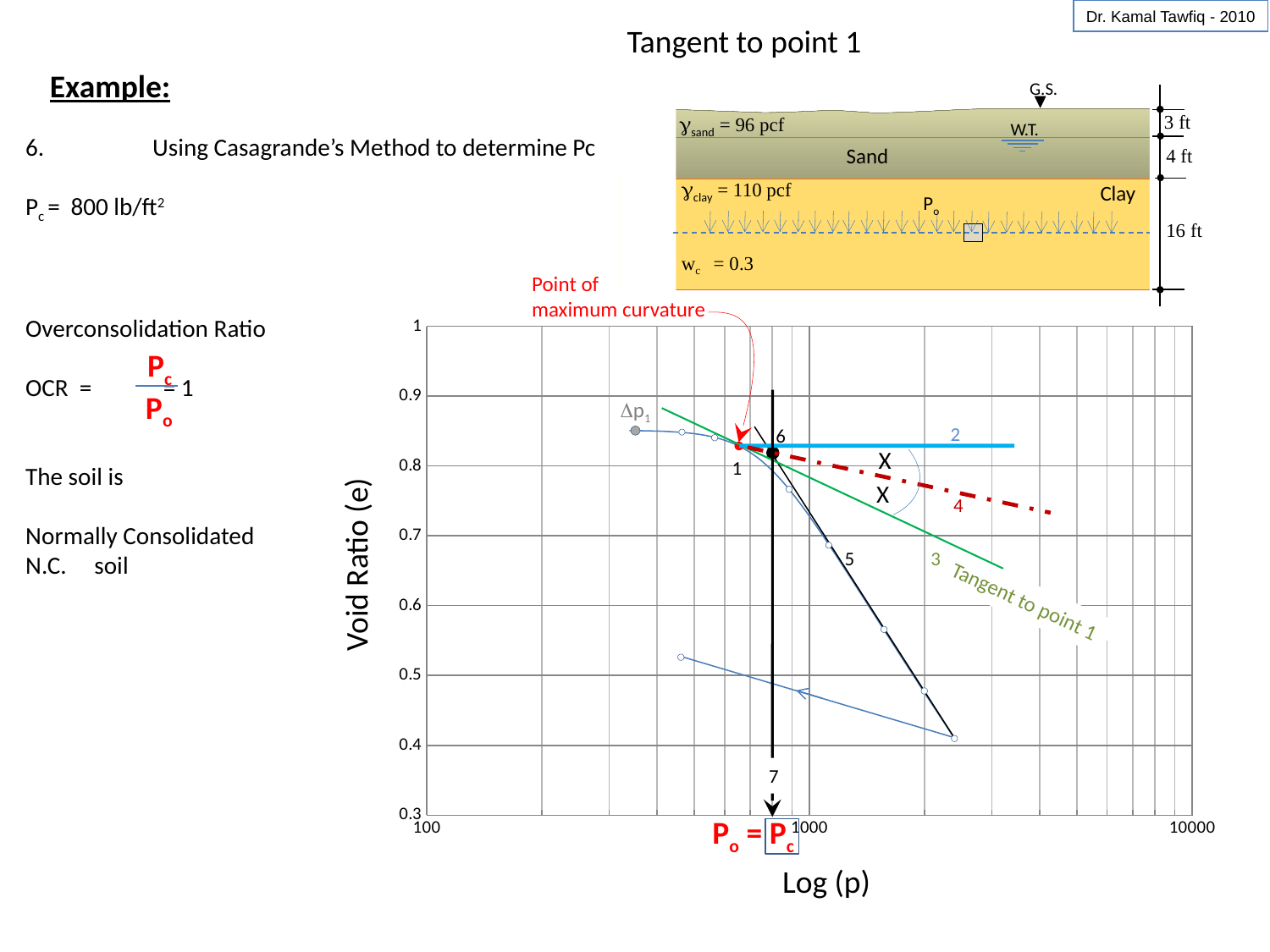
Which point has the higher void ratio, the point labelled Δp1 or the point labelled 5? Δp1 Is the pressure at the vertical line marked Po = Pc greater or less than 1000? less What is the highest tick value shown on the vertical axis of the chart? 1 What is the label of the horizontal axis of the chart? Log (p) As p increases along the x axis, does the void ratio along the main loading curve rise or fall? fall Is the void ratio at the point labelled Δp1 greater or less than 0.8? greater Is the void ratio at the lowest point of the loading curve greater or less than 0.5? less What kind of chart is shown on the slide? line chart What is the label of the vertical axis of the chart? Void Ratio (e)